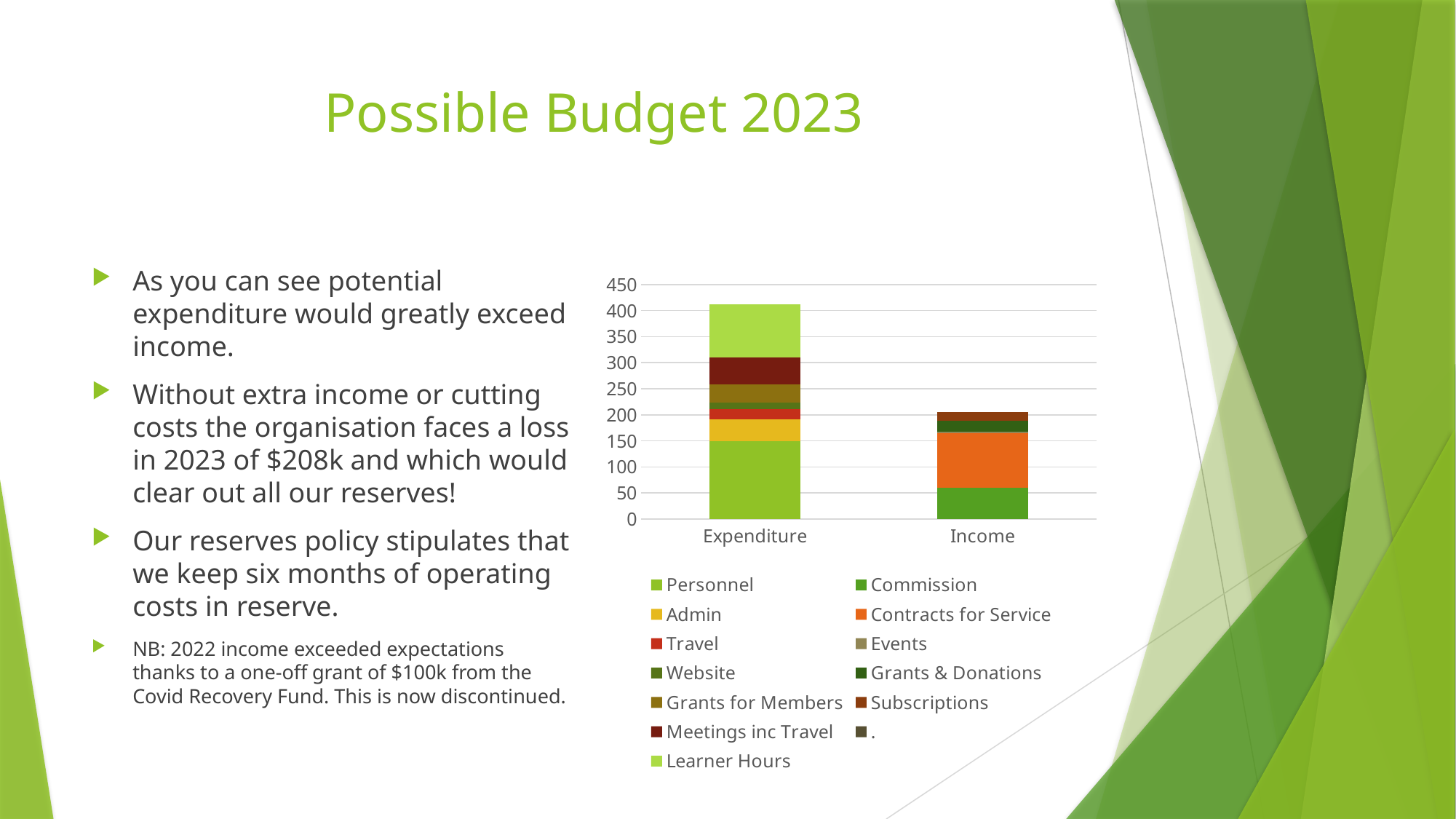
How many categories are shown on the x axis of the chart? 2 Is the total of the Income bar greater or less than 250? less Do the bar totals rise or fall from Expenditure to Income along the x axis? fall Which series forms the bottom segment of the Income bar? Commission Which category has the lowest total in the chart? Income Is the Personnel segment of the Expenditure bar greater or less than 100? greater Which category has the taller stacked bar, Expenditure or Income? Expenditure What kind of chart is shown on the slide? Stacked bar chart Is the total of the Income bar greater or less than 150? greater Which series forms the bottom segment of the Expenditure bar? Personnel Which category has the highest total in the chart? Expenditure